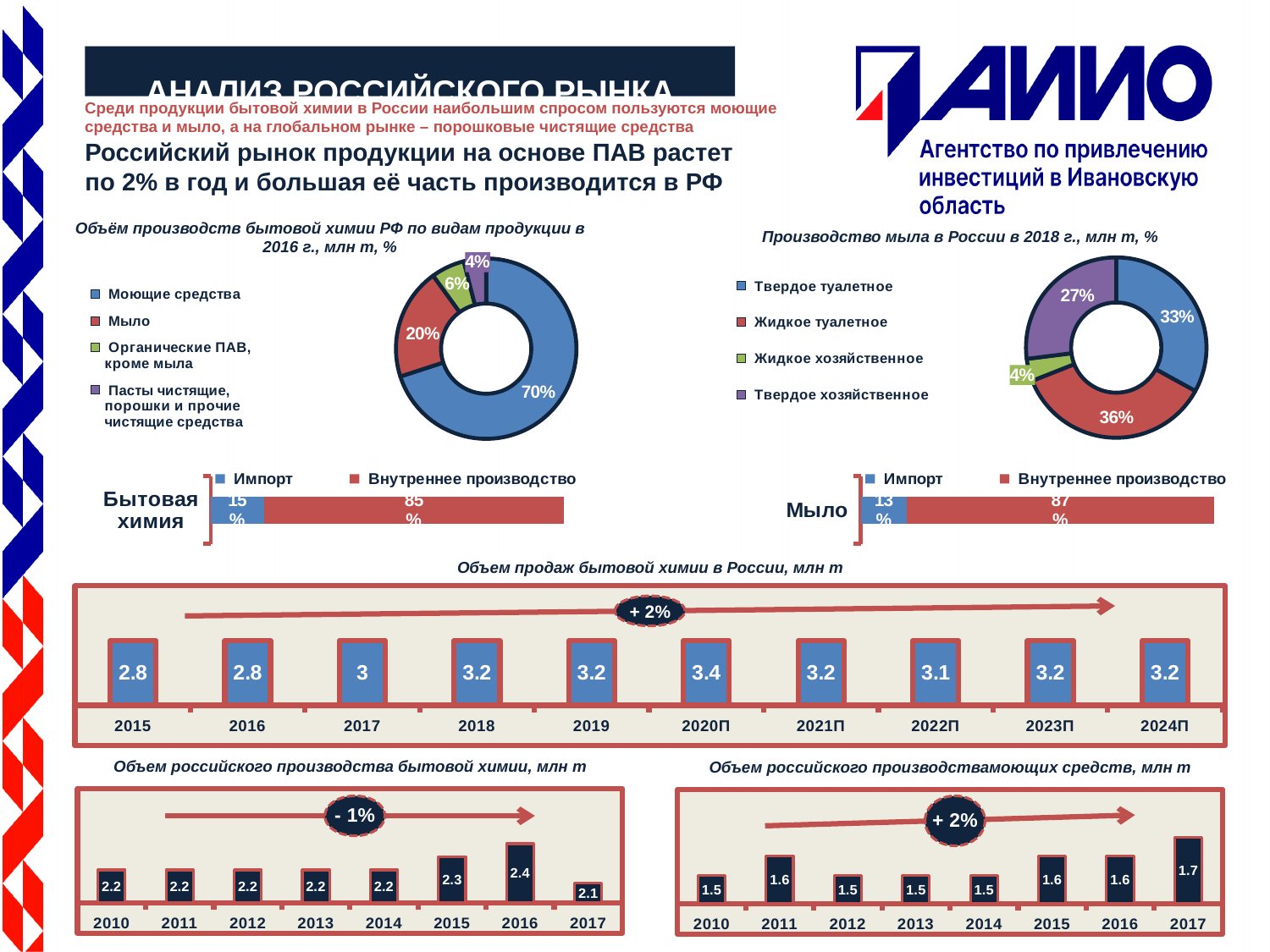
In the donut chart 'Производство мыла в России в 2018 г.', what share does 'Твердое хозяйственное' have? 27% In the chart 'Объем российского производства моющих средств, млн т', which year has the highest value? 2017 In the donut chart 'Производство мыла в России в 2018 г.', how many categories does the legend list? 4 In the chart 'Объем продаж бытовой химии в России, млн т', how many years are shown on the x axis? 10 In the chart 'Объем российского производства бытовой химии, млн т', what is the difference between the values for 2016 and 2017? 0.3 In the stacked bar labelled 'Бытовая химия', what is the value for 'Импорт'? 15% In the stacked bar labelled 'Мыло', what is the value for 'Внутреннее производство'? 87% In the donut chart 'Объём производств бытовой химии РФ по видам продукции в 2016 г.', which category has the smallest share? Пасты чистящие, порошки и прочие чистящие средства In the donut chart 'Объём производств бытовой химии РФ по видам продукции в 2016 г.', what share does 'Моющие средства' have? 70% What kind of chart is 'Объем российского производства моющих средств, млн т'? bar chart In the chart 'Объем продаж бытовой химии в России, млн т', what is the value for 2020П? 3.4 In the donut chart 'Производство мыла в России в 2018 г.', which category has the largest share? Жидкое туалетное